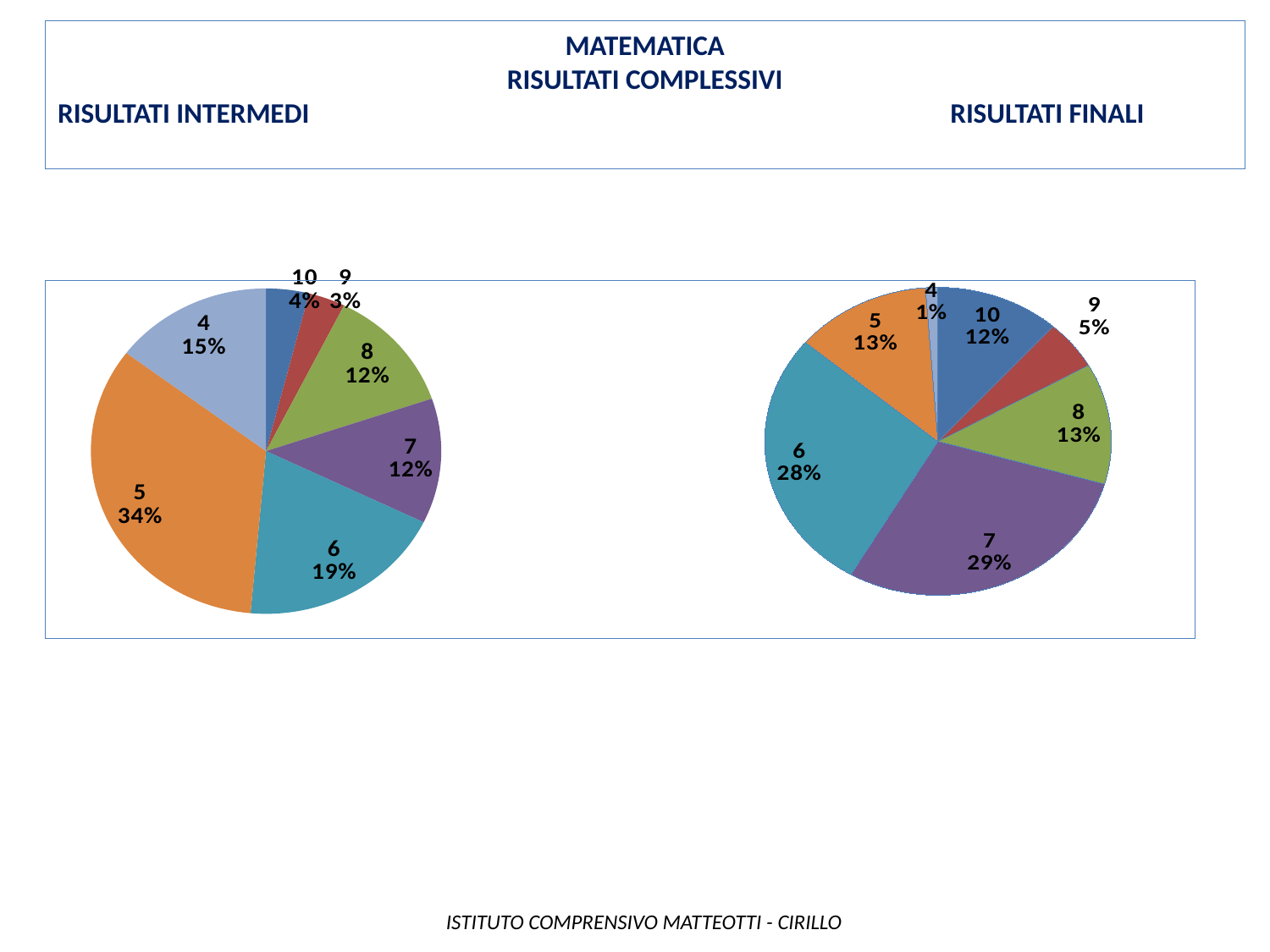
In the RISULTATI FINALI pie chart, what share does grade 10 have? 12% In the RISULTATI INTERMEDI pie chart, which grade has the largest slice? 5 In the RISULTATI INTERMEDI pie chart, which is larger: the slice for grade 4 or the slice for grade 8? 4 In the RISULTATI INTERMEDI pie chart, what share does grade 5 have? 34% In the RISULTATI FINALI pie chart, what share does grade 7 have? 29% How many slices does the RISULTATI FINALI pie chart have? 7 In the RISULTATI FINALI pie chart, what is the difference in percentage points between grade 10 and grade 9? 7 In the RISULTATI FINALI pie chart, which grade has the largest slice? 7 In the RISULTATI FINALI pie chart, which grade has the smallest slice? 4 In the RISULTATI INTERMEDI pie chart, which grade has the smallest slice? 9 In the RISULTATI INTERMEDI pie chart, what is the difference in percentage points between grade 5 and grade 6? 15 What type of chart is used for RISULTATI INTERMEDI? Pie chart